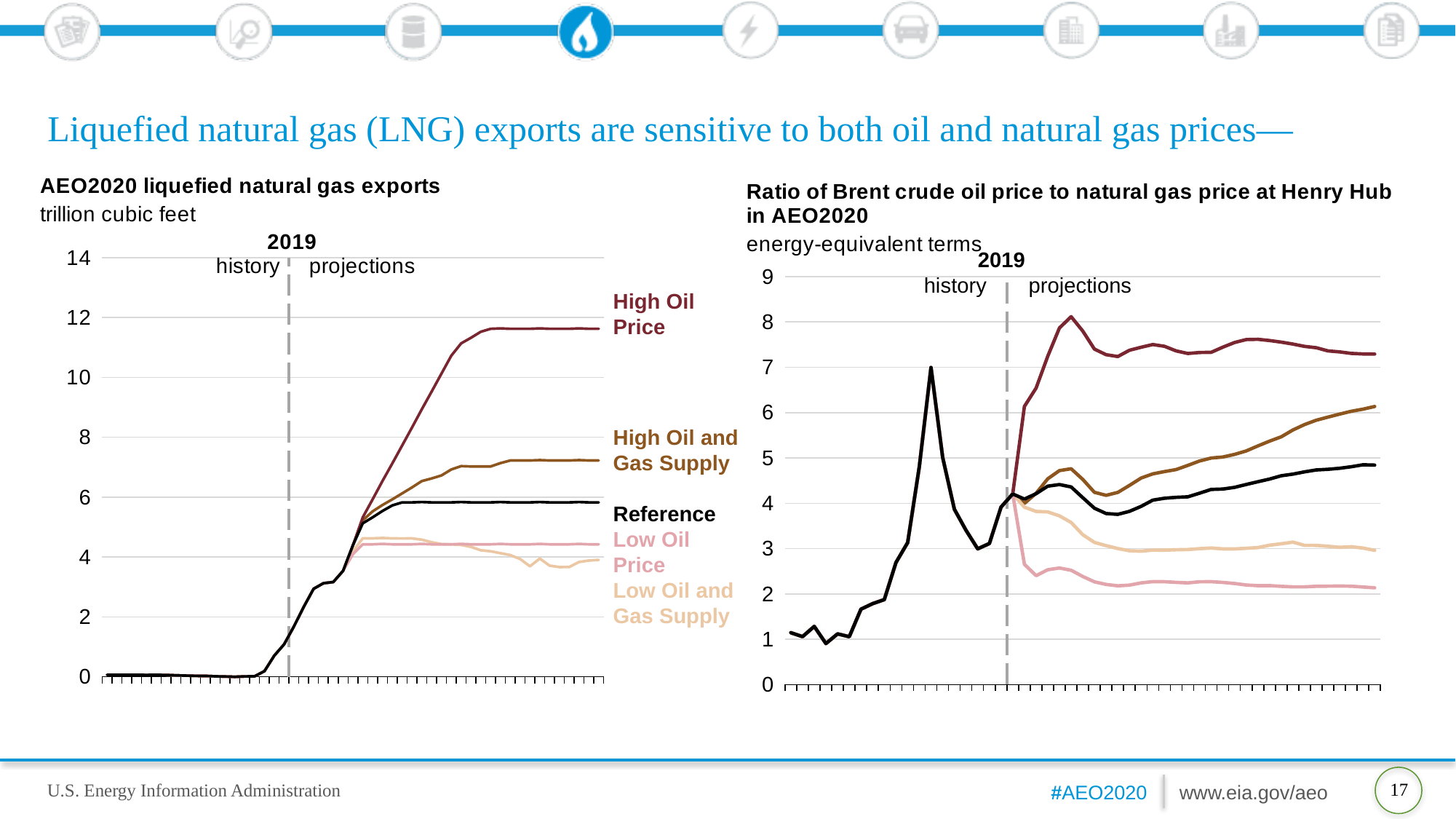
How many series are labelled on the left chart, 'AEO2020 liquefied natural gas exports'? 5 On the left chart, 'AEO2020 liquefied natural gas exports', is the final value of the Reference series greater or less than 4? greater On the left chart, 'AEO2020 liquefied natural gas exports', is the final value of the High Oil Price series greater or less than 10? greater On the left chart, 'AEO2020 liquefied natural gas exports', which is larger at the end of the projections: High Oil and Gas Supply or Reference? High Oil and Gas Supply What year separates history from projections on both charts? 2019 What kind of chart is the left chart, 'AEO2020 liquefied natural gas exports'? line chart On the right chart, 'Ratio of Brent crude oil price to natural gas price at Henry Hub in AEO2020', is the final value of the top (dark red) line greater or less than 7? greater On the left chart, 'AEO2020 liquefied natural gas exports', which series has the lowest value at the end of the projection period? Low Oil and Gas Supply On the left chart, 'AEO2020 liquefied natural gas exports', which series has the highest value at the end of the projection period? High Oil Price What unit is used on the left chart, 'AEO2020 liquefied natural gas exports'? trillion cubic feet On the left chart, 'AEO2020 liquefied natural gas exports', do LNG exports rise or fall from the start of the history period to the end of the projections? rise